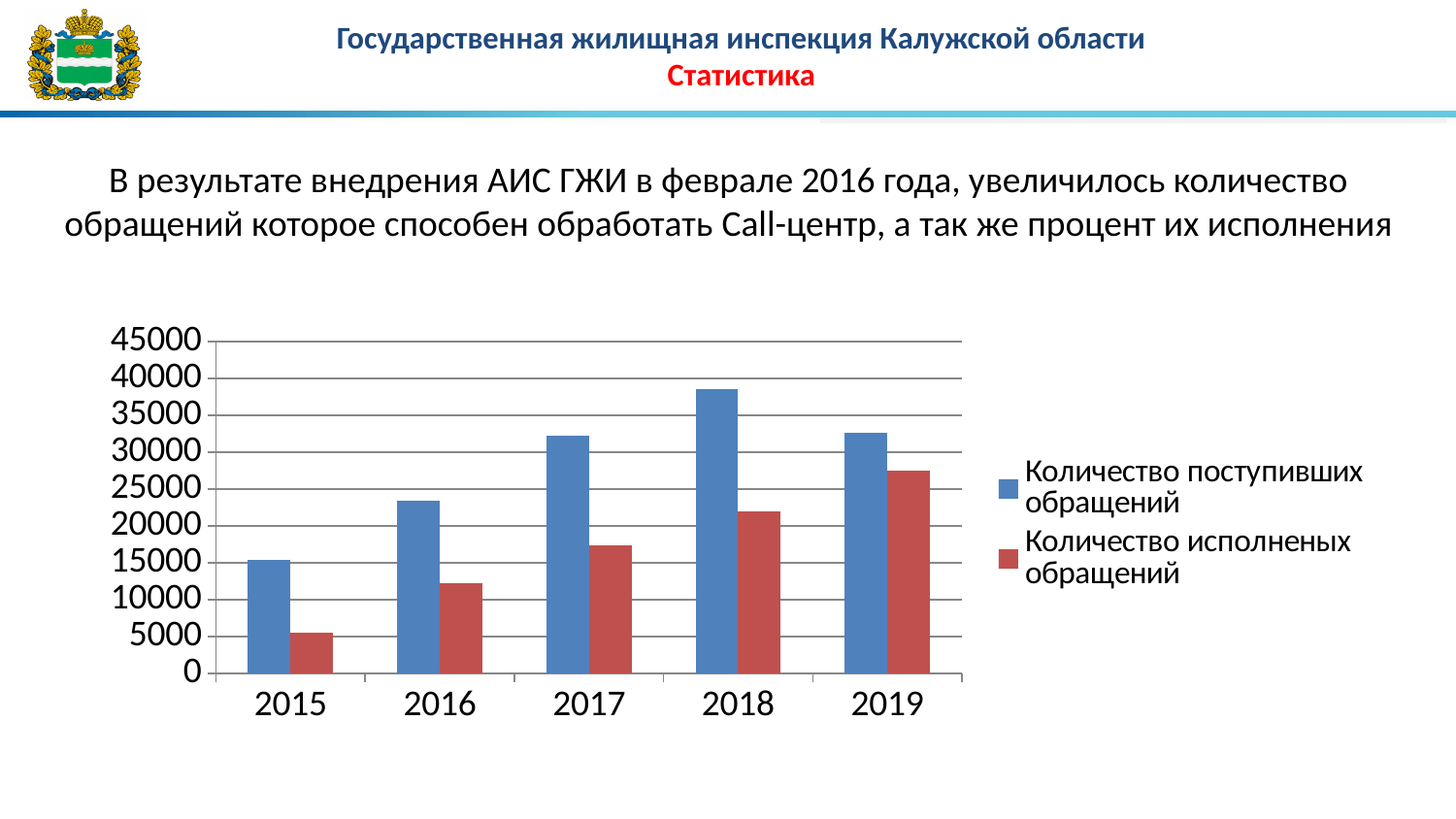
In which year is the value for Количество поступивших обращений the highest? 2018 How many series does the legend list? 2 Is the value for Количество исполненых обращений in 2015 greater or less than 10000? less In which year is the value for Количество поступивших обращений the lowest? 2015 In which year is the value for Количество исполненых обращений the lowest? 2015 Does the value for Количество исполненых обращений rise or fall from 2015 to 2019? rise How many years are shown on the x axis? 5 In which year is the value for Количество исполненых обращений the highest? 2019 Which is larger in 2016: Количество поступивших обращений or Количество исполненых обращений? Количество поступивших обращений Is the value for Количество исполненых обращений in 2019 greater or less than 25000? greater What kind of chart is shown on the slide? bar chart Is the value for Количество поступивших обращений in 2018 greater or less than 35000? greater